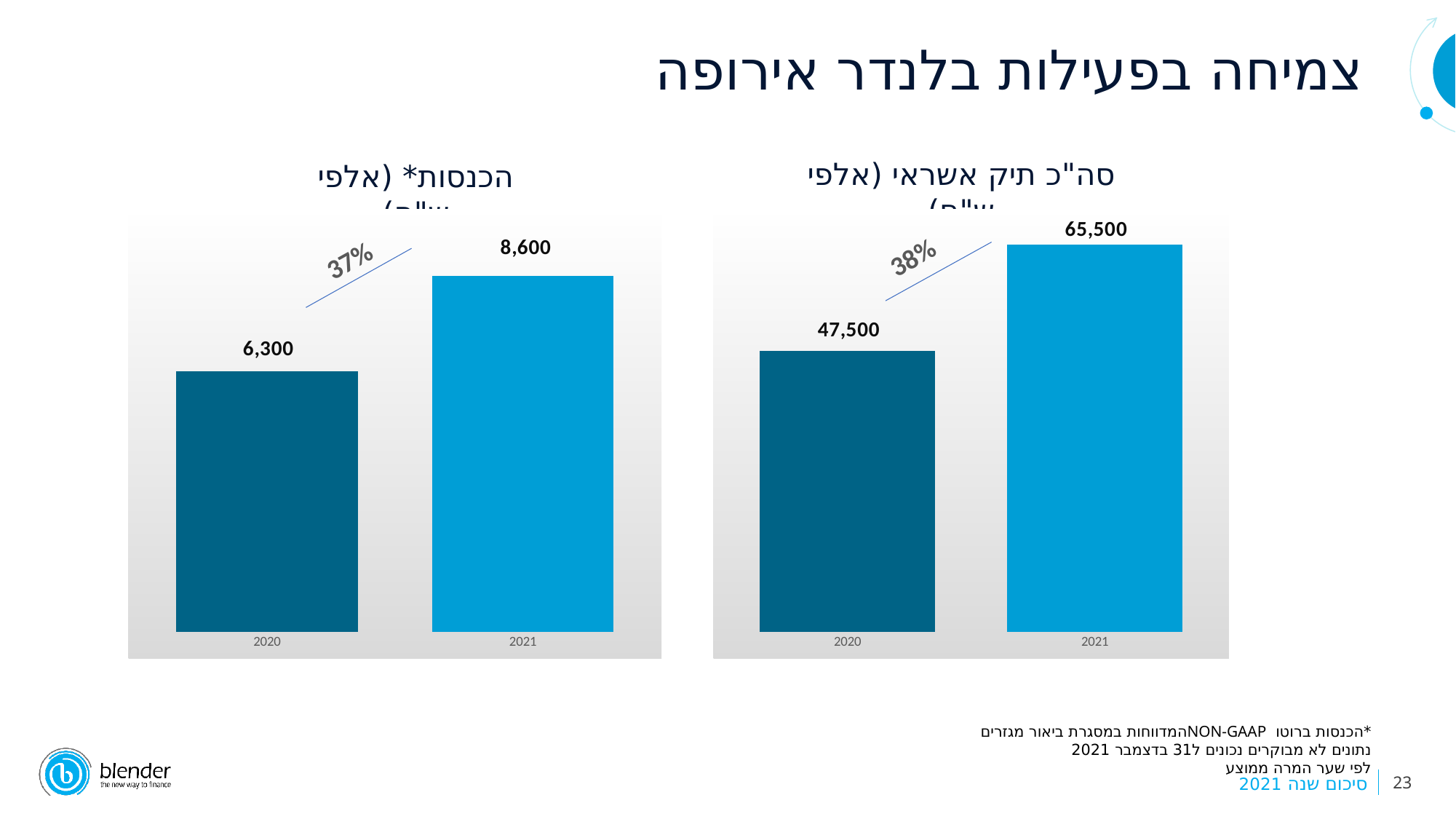
On the left chart, what is the value for 2020? 6,300 On the left chart, what is the difference between the 2021 and 2020 values? 2,300 On the right chart, what is the value for 2020? 47,500 On the left chart, how many bars are plotted? 2 On the left chart, what is the value for 2021? 8,600 On the right chart, which year has the higher value? 2021 On the right chart, what is the difference between the 2021 and 2020 values? 18,000 What growth percentage is annotated on the left chart? 37% On the right chart, do the values rise or fall from 2020 to 2021? Rise What type of chart is the right chart? Bar chart On the left chart, which year has the lower value? 2020 On the right chart, what is the value for 2021? 65,500